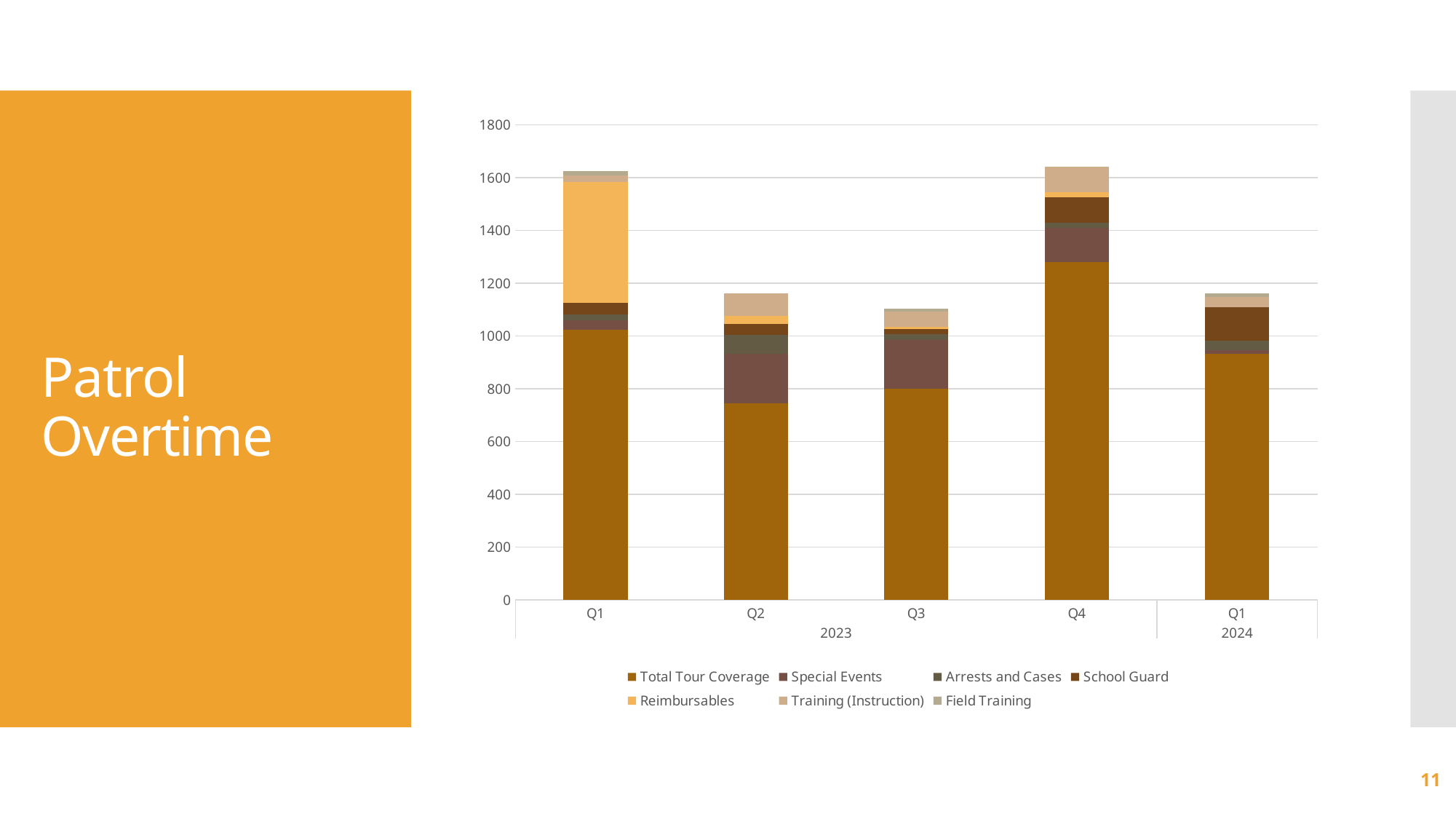
Is the total height of the Q1 2024 bar greater or less than 1200? less How many bars (quarters) are plotted in the chart? 5 How many series does the legend list? 7 Which bar has the larger total, Q4 2023 or Q3 2023? Q4 2023 Is the total height of the Q2 2023 bar greater or less than 1000? greater Which quarter has the larger Total Tour Coverage segment, Q4 2023 or Q1 2023? Q4 2023 What kind of chart is shown on the slide? stacked bar chart Is the Total Tour Coverage value for Q2 2023 greater or less than 800? less Which quarter's bar contains the large Reimbursables segment? Q1 2023